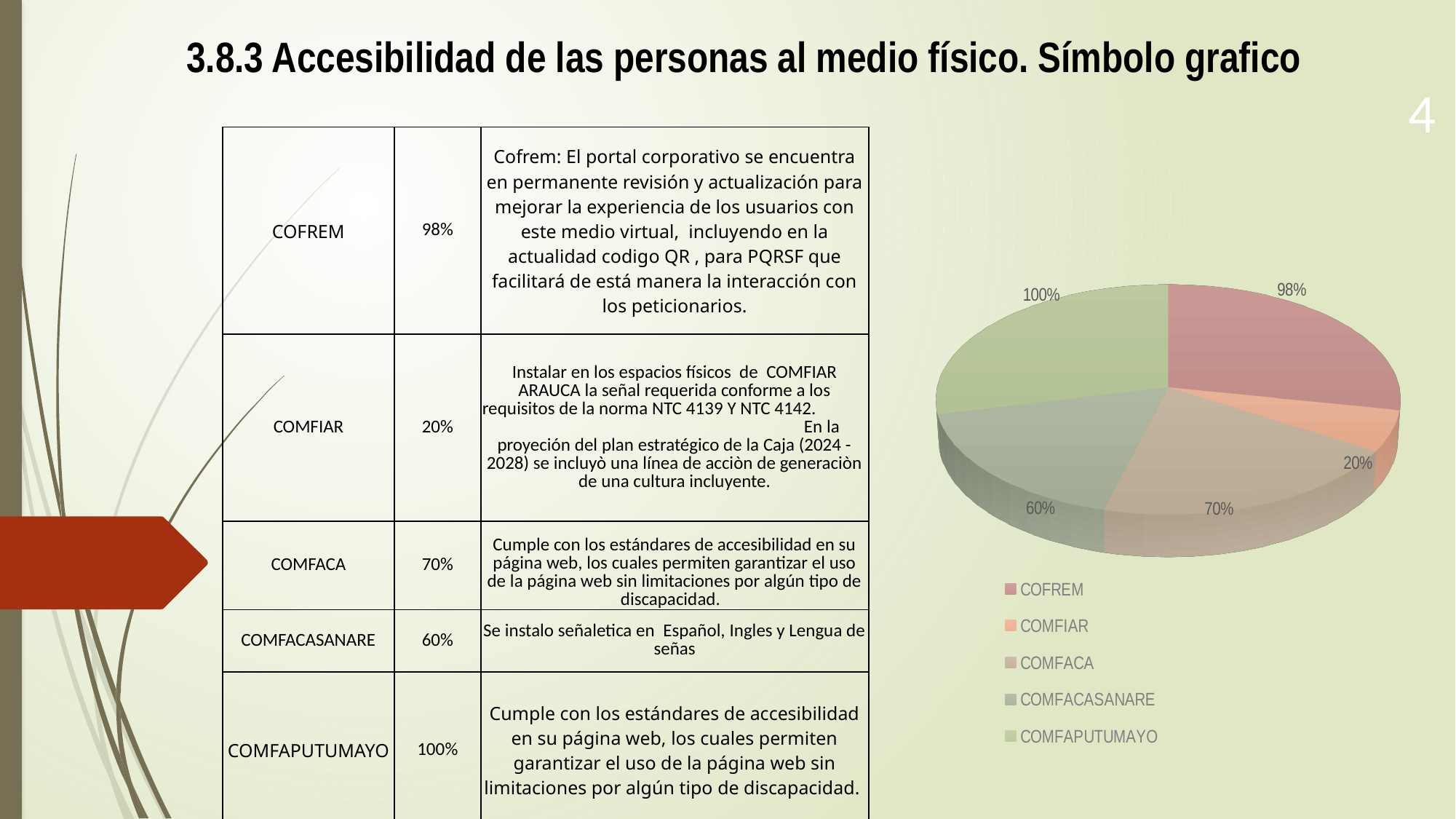
What value is shown for COMFAPUTUMAYO in the pie chart? 100% How many categories does the pie chart show? 5 Which category has the highest value in the pie chart? COMFAPUTUMAYO What value is shown for COFREM in the pie chart? 98% What value is shown for COMFACA in the pie chart? 70% Which category has the lowest value in the pie chart? COMFIAR Which category is listed first in the pie chart's legend? COFREM Which has a larger value, COMFACA or COMFACASANARE? COMFACA What kind of chart is shown on the slide? pie chart What value is shown for COMFIAR in the pie chart? 20% What value is shown for COMFACASANARE in the pie chart? 60% What is the difference between the values for COMFAPUTUMAYO and COMFIAR? 80%